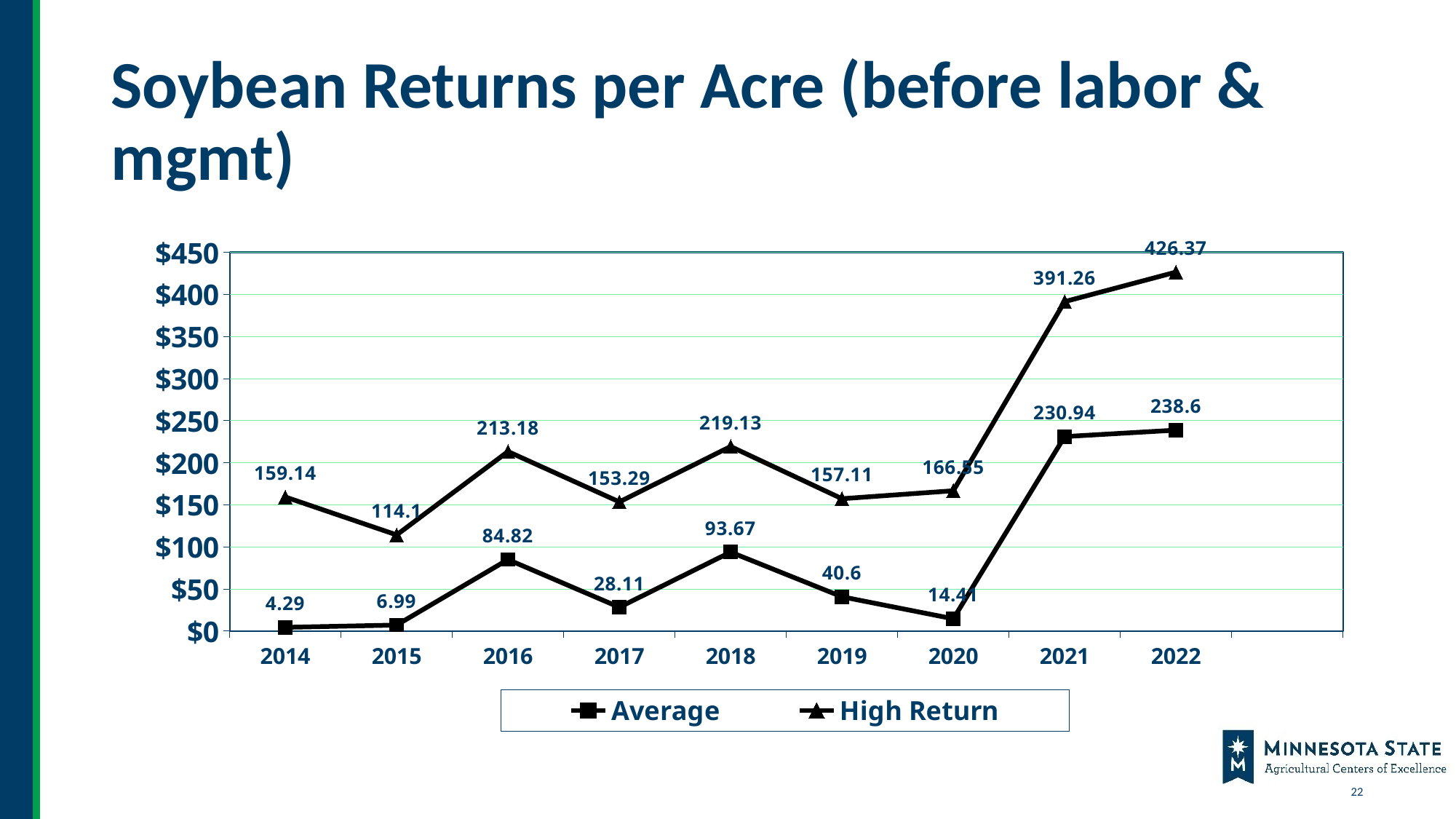
What is the Average soybean return per acre in 2016? 84.82 Which series is shown with triangle markers in the legend? High Return What is the High Return value for 2021? 391.26 Which is larger, the High Return value in 2016 or the High Return value in 2018? 2018 Is the Average value for 2021 greater or less than $200? greater What is the difference between the High Return and Average values in 2022? 187.77 What is the Average value for 2014? 4.29 What type of chart is shown on the slide? line chart How many years are plotted along the x axis? 9 In which year is the High Return series at its highest? 2022 How many series does the legend list? 2 In which year is the Average series at its lowest? 2014